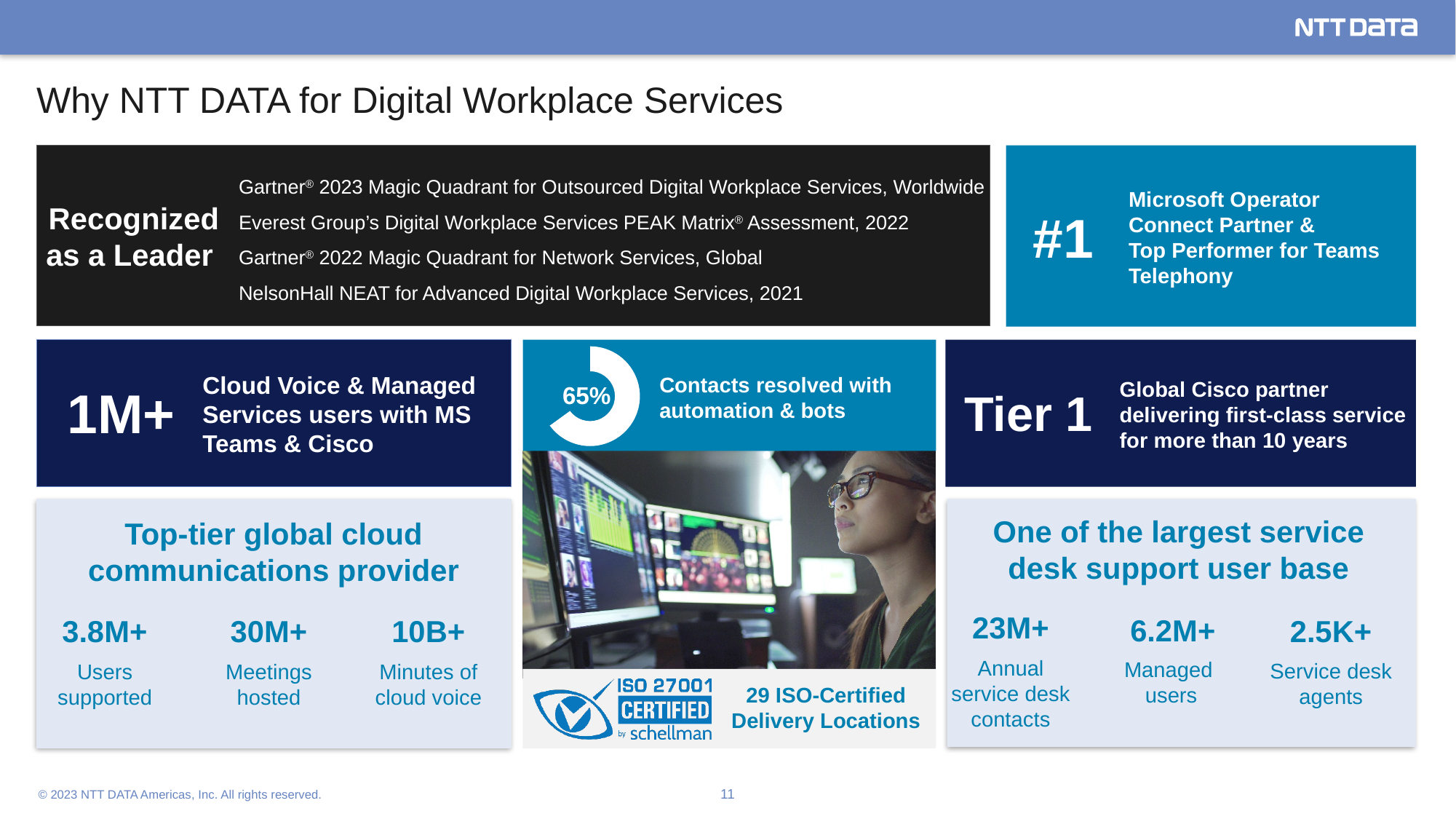
What percentage does the donut chart on the slide show for contacts resolved with automation & bots? 65% Is the value shown in the donut chart greater or less than 50%? greater What colour is the filled segment of the donut chart? White What share of contacts does the donut chart indicate are resolved with automation & bots? 65% What metric does the donut chart on the slide describe? Contacts resolved with automation & bots Is the filled portion of the donut chart larger or smaller than the unfilled portion? larger What kind of chart is used to show the share of contacts resolved with automation & bots? Donut (pie) chart